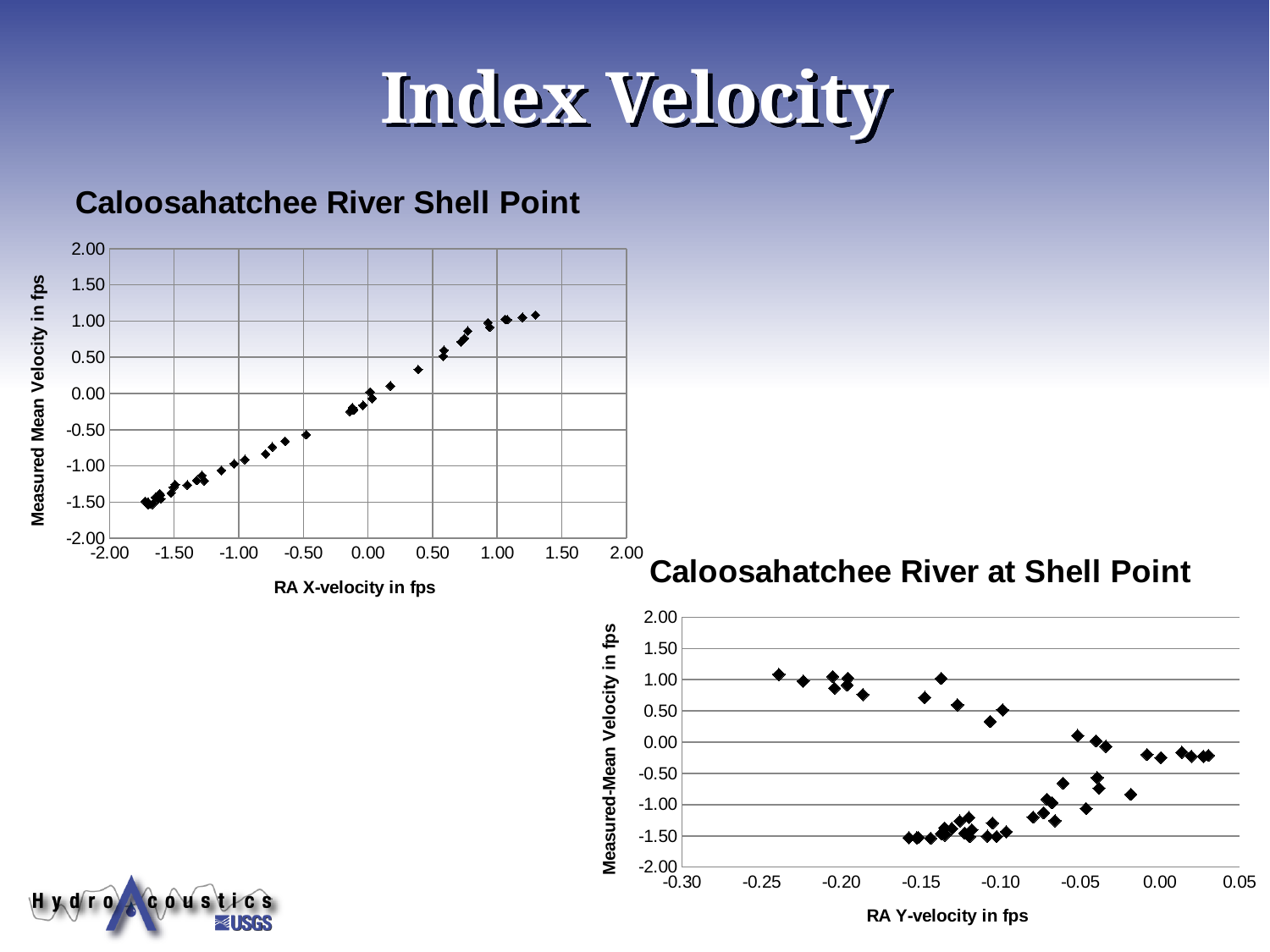
In the right chart, 'Caloosahatchee River at Shell Point', do the measured mean velocity values generally rise or fall as RA Y-velocity increases? fall What kind of chart is the 'Caloosahatchee River Shell Point' chart on the left? scatter chart What kind of chart is the 'Caloosahatchee River at Shell Point' chart on the right? scatter chart In the left chart, 'Caloosahatchee River Shell Point', is the measured mean velocity at an RA X-velocity of -1.50 fps greater or less than -1.00? less In the right chart, 'Caloosahatchee River at Shell Point', are the points near an RA Y-velocity of -0.15 fps greater or less than -1.00 in measured mean velocity? less How many charts are shown on the slide? 2 In the left chart, 'Caloosahatchee River Shell Point', is the measured mean velocity at an RA X-velocity of 1.00 fps greater or less than 0.50? greater In the left chart, 'Caloosahatchee River Shell Point', do the measured mean velocity values rise or fall as RA X-velocity increases? rise What is the x-axis title of the left chart, 'Caloosahatchee River Shell Point'? RA X-velocity in fps What is the x-axis title of the right chart, 'Caloosahatchee River at Shell Point'? RA Y-velocity in fps